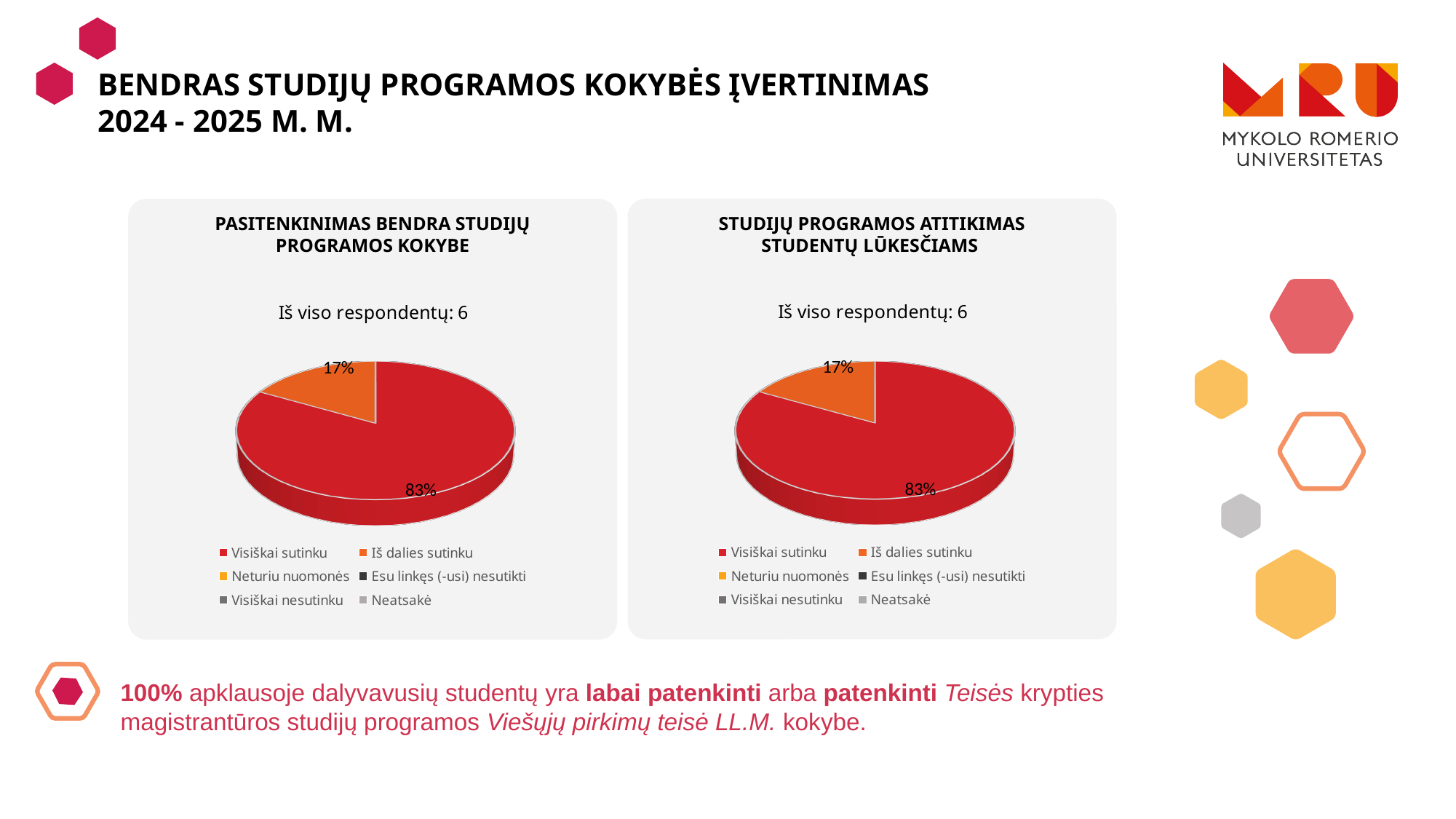
In the chart titled "Studijų programos atitikimas studentų lūkesčiams", what share of respondents answered "Visiškai sutinku"? 83% In the left chart, which response category has the largest slice? Visiškai sutinku In the right chart, which is larger: the "Visiškai sutinku" slice or the "Iš dalies sutinku" slice? Visiškai sutinku How many entries does the legend of the left chart list? 6 How many respondents in total are reported for the chart titled "Studijų programos atitikimas studentų lūkesčiams"? 6 In the chart titled "Pasitenkinimas bendra studijų programos kokybe", what share of respondents answered "Visiškai sutinku"? 83% In the left chart, what is the difference in percentage points between the "Visiškai sutinku" and "Iš dalies sutinku" slices? 66 percentage points In the chart titled "Studijų programos atitikimas studentų lūkesčiams", what share of respondents answered "Iš dalies sutinku"? 17% What type of chart is used in the "Pasitenkinimas bendra studijų programos kokybe" panel? Pie chart In the right chart, which response category has the smallest visible slice? Iš dalies sutinku In the left chart, what colour is the "Iš dalies sutinku" slice? Orange In the chart titled "Pasitenkinimas bendra studijų programos kokybe", what share of respondents answered "Iš dalies sutinku"? 17%